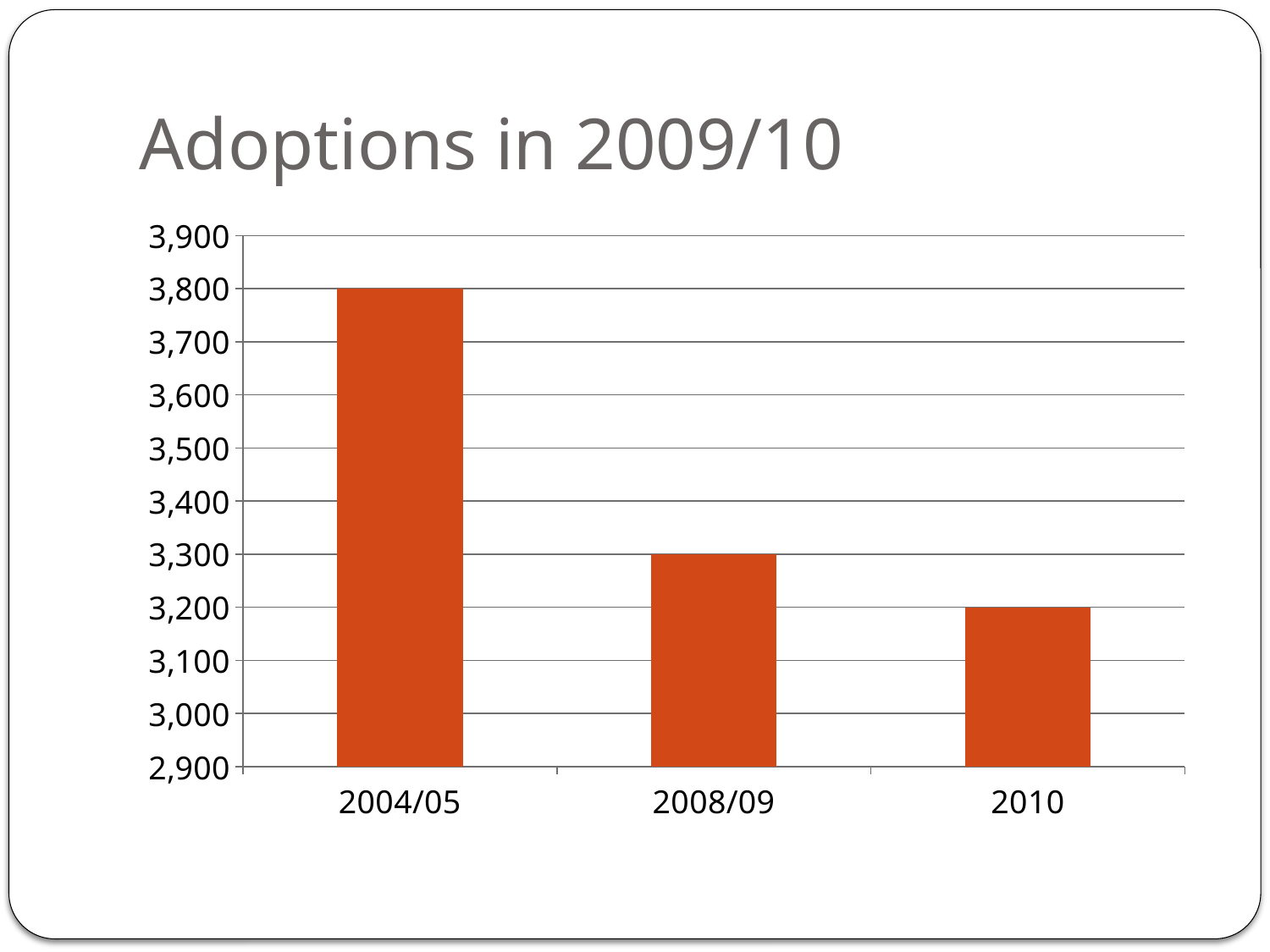
What is the difference between the values for 2004/05 and 2010? 600 How many categories are shown on the x axis? 3 Which is larger, the value for 2004/05 or the value for 2008/09? 2004/05 Which category has the lowest value? 2010 What is the value for 2010? 3,200 What is the value for 2004/05? 3,800 Is the value for 2008/09 greater or less than 3,500? less Which category has the highest value? 2004/05 Do the values rise or fall from 2004/05 to 2010? fall What is the difference between the values for 2008/09 and 2010? 100 What kind of chart is shown on the slide? bar chart What is the value for 2008/09? 3,300